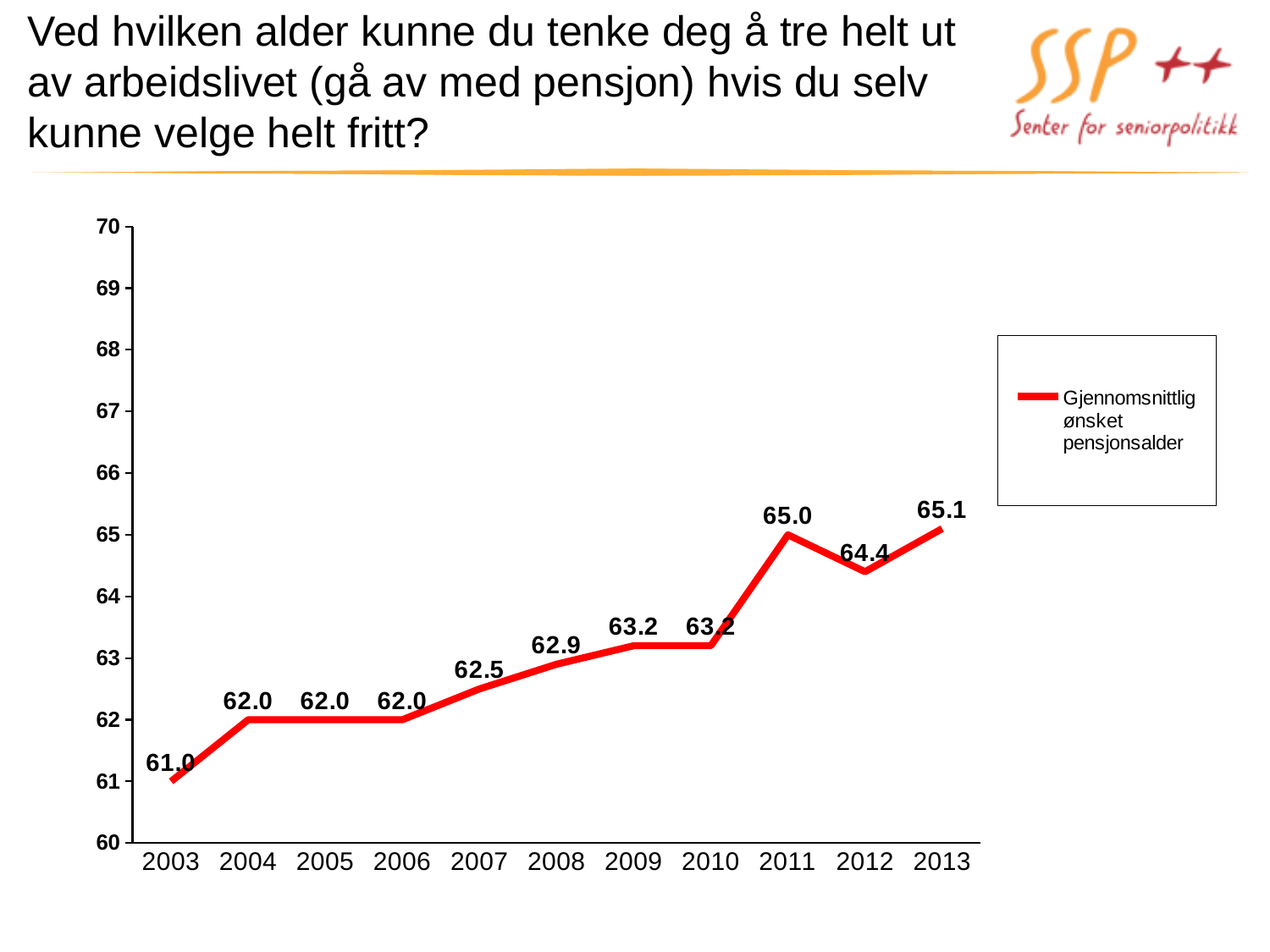
What kind of chart is shown? line chart Which year has the highest value? 2013 How many years are plotted on the x axis? 11 What is the value for 2003? 61.0 What is the value for 2011? 65.0 What is the legend entry for the plotted series? Gjennomsnittlig ønsket pensjonsalder Which is larger, the value for 2011 or the value for 2012? 2011 Which year has the lowest value? 2003 How many series does the legend list? 1 What is the difference between the values for 2013 and 2003? 4.1 Is the value for 2009 greater or less than 63? greater What is the value for 2012? 64.4